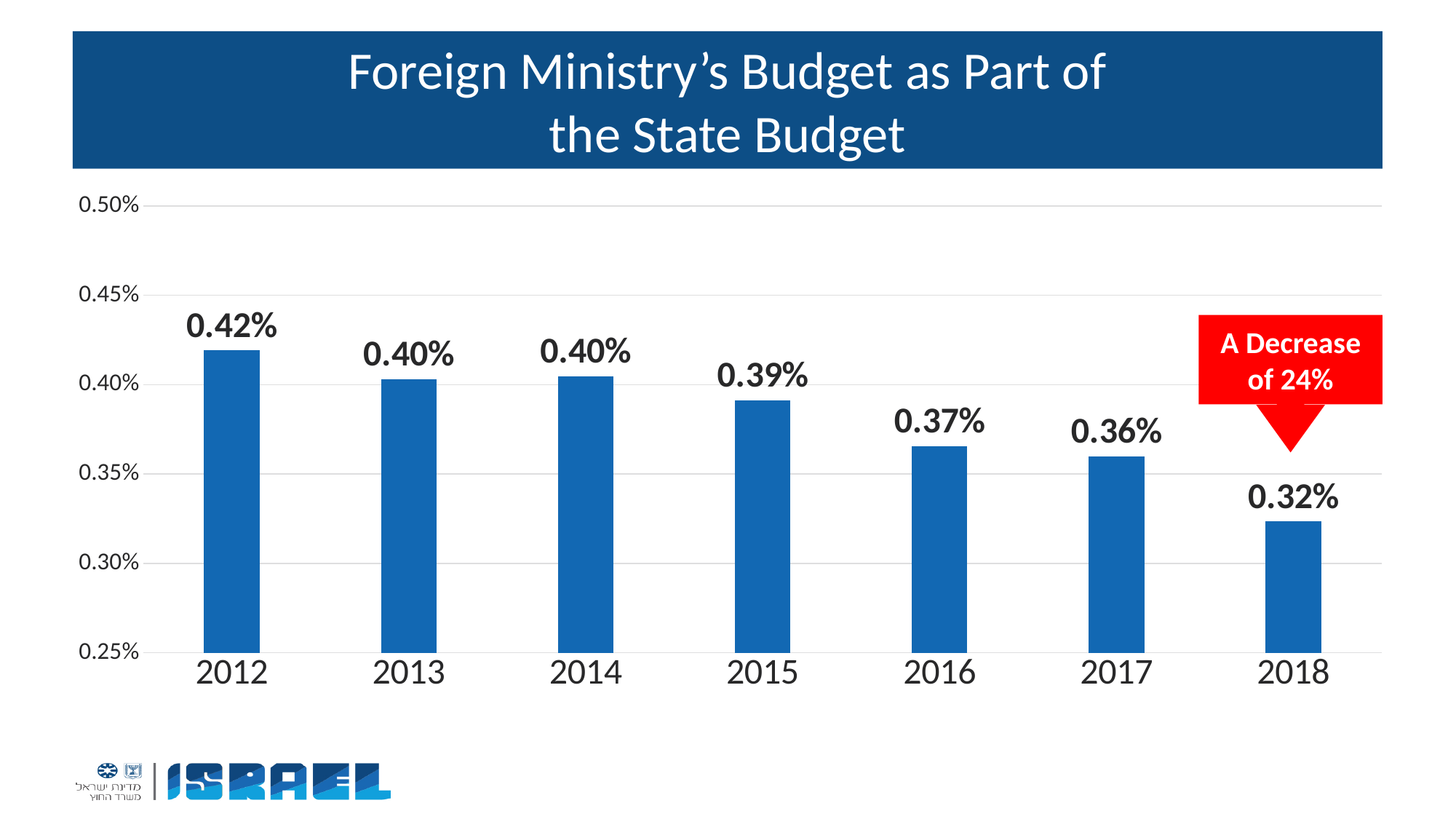
Is the value for 2018 greater or less than 0.35%? less What is the difference between the values for 2012 and 2018? 0.10% Which year has the lowest value? 2018 What is the value for 2015? 0.39% Do the values generally rise or fall from 2012 to 2018? fall Which is larger, the value for 2016 or the value for 2017? 2016 What is the value for 2012? 0.42% What kind of chart is shown? bar chart What is the value for 2018? 0.32% How many years are shown on the x axis? 7 What does the red callout above the 2018 bar say? A Decrease of 24% Which year has the highest value? 2012